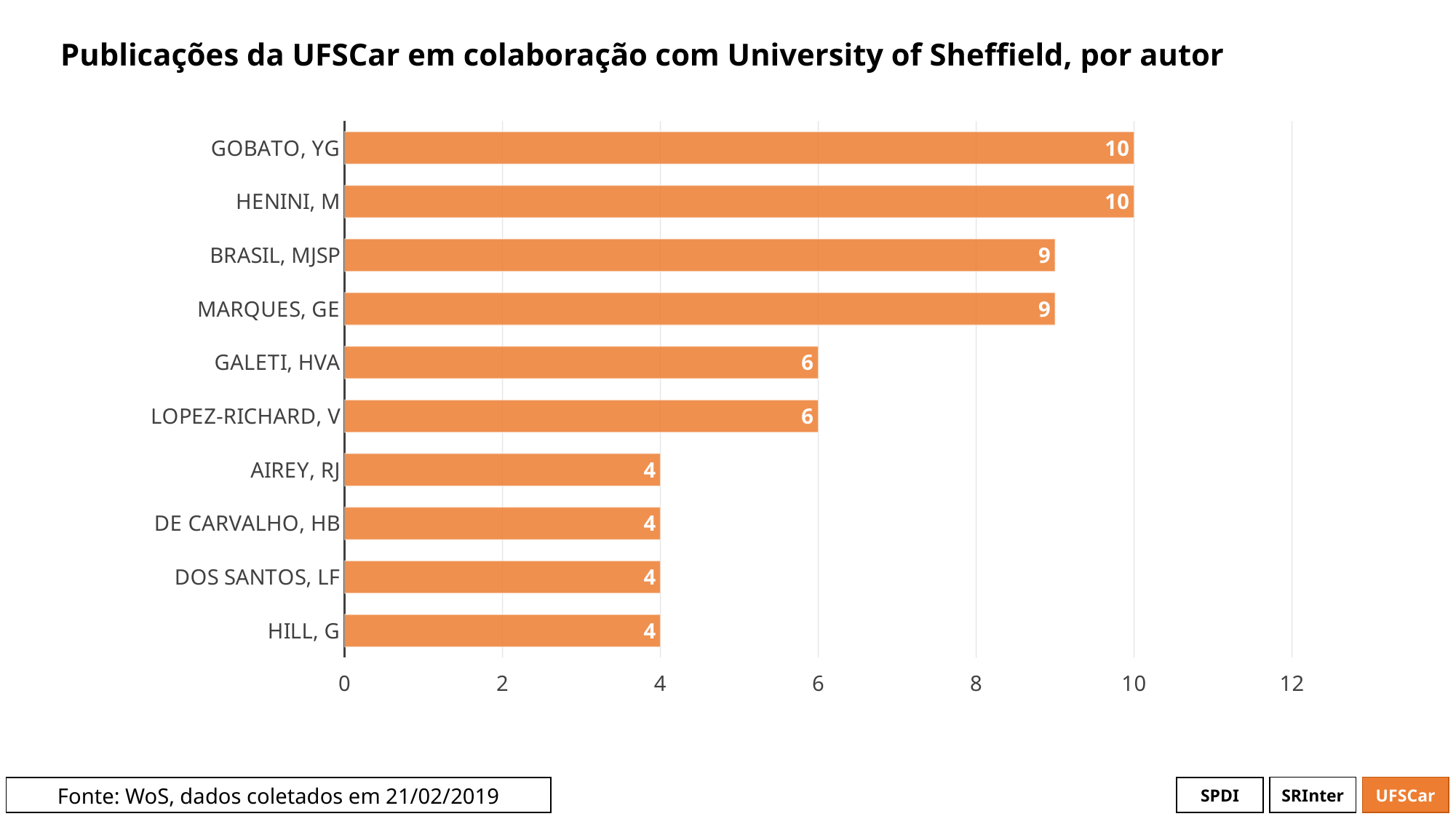
What is the difference between the values for MARQUES, GE and AIREY, RJ? 5 What is the value for BRASIL, MJSP? 9 Which is larger, the value for BRASIL, MJSP or the value for GALETI, HVA? BRASIL, MJSP How many publications does GOBATO, YG have? 10 What is the value for HILL, G? 4 What is the difference between the values for HENINI, M and LOPEZ-RICHARD, V? 4 What is the value for GALETI, HVA? 6 Which authors have the highest number of publications? GOBATO, YG and HENINI, M What kind of chart is shown on the slide? bar chart How many authors are shown in the chart? 10 What is the title of the chart? Publicações da UFSCar em colaboração com University of Sheffield, por autor Is the value for DE CARVALHO, HB greater or less than 6? less